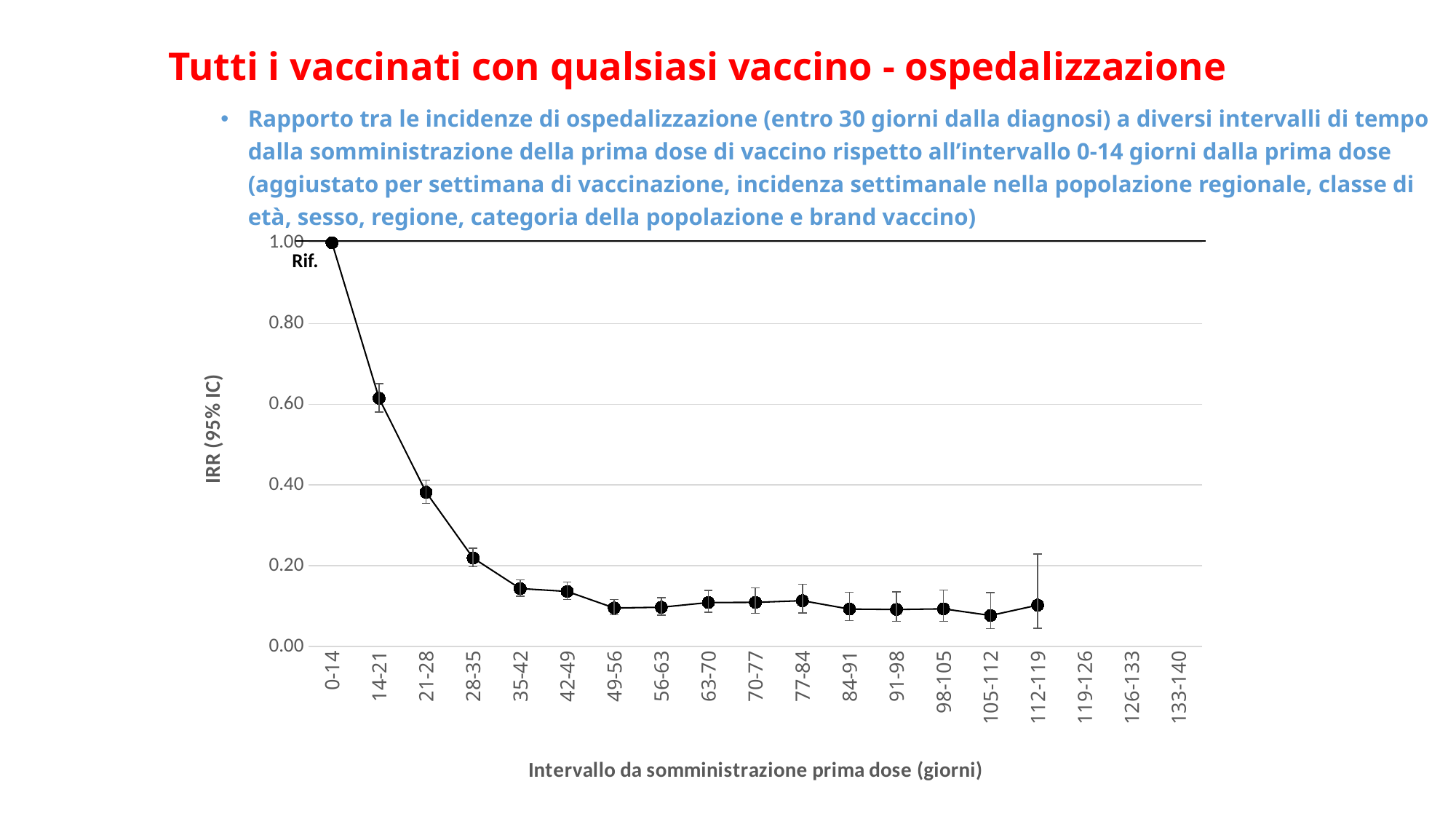
Is the IRR value for the 14-21 interval greater or less than 0.80? less What is the label of the x axis? Intervallo da somministrazione prima dose (giorni) Which interval has the highest IRR value? 0-14 What kind of chart is shown on the slide? line chart What is the IRR value for the 0-14 day interval (the reference point)? 1.00 Do the IRR values rise or fall as the interval from the first dose increases from 0-14 to 35-42 days? fall Which interval has the lowest IRR value? 105-112 Is the IRR value for the 35-42 interval greater or less than 0.20? less What is the label of the y axis? IRR (95% IC) Which has a larger IRR value, the 14-21 interval or the 21-28 interval? 14-21 Is the IRR value for the 21-28 interval greater or less than 0.60? less How many data points are plotted on the chart? 16